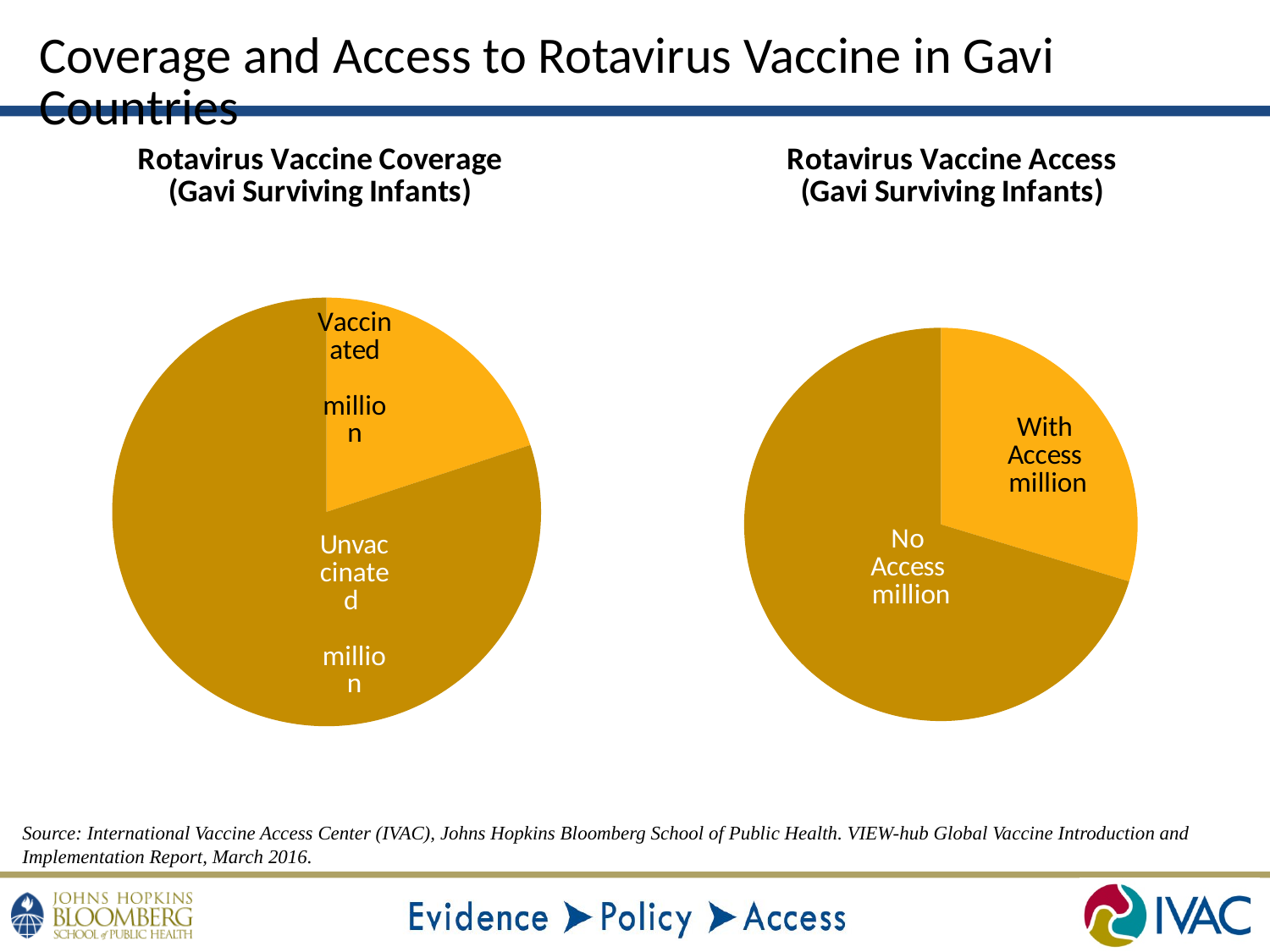
What is the title of the pie chart on the right of the slide? Rotavirus Vaccine Access (Gavi Surviving Infants) How many slices does the 'Rotavirus Vaccine Coverage' pie chart on the left have? 2 In the 'Rotavirus Vaccine Coverage' pie chart on the left, which slice is the smallest? Vaccinated What is the title of the pie chart on the left of the slide? Rotavirus Vaccine Coverage (Gavi Surviving Infants) What kind of chart is the 'Rotavirus Vaccine Coverage (Gavi Surviving Infants)' chart on the left? Pie chart In the 'Rotavirus Vaccine Access' pie chart on the right, which slice is the largest? No Access In the 'Rotavirus Vaccine Access' pie chart on the right, which is larger: the With Access slice or the No Access slice? No Access What kind of chart is the 'Rotavirus Vaccine Access (Gavi Surviving Infants)' chart on the right? Pie chart How many slices does the 'Rotavirus Vaccine Access' pie chart on the right have? 2 In the 'Rotavirus Vaccine Access' pie chart on the right, which slice is the smallest? With Access In the 'Rotavirus Vaccine Coverage' pie chart on the left, which is larger: the Vaccinated slice or the Unvaccinated slice? Unvaccinated In the 'Rotavirus Vaccine Coverage' pie chart on the left, which slice is the largest? Unvaccinated